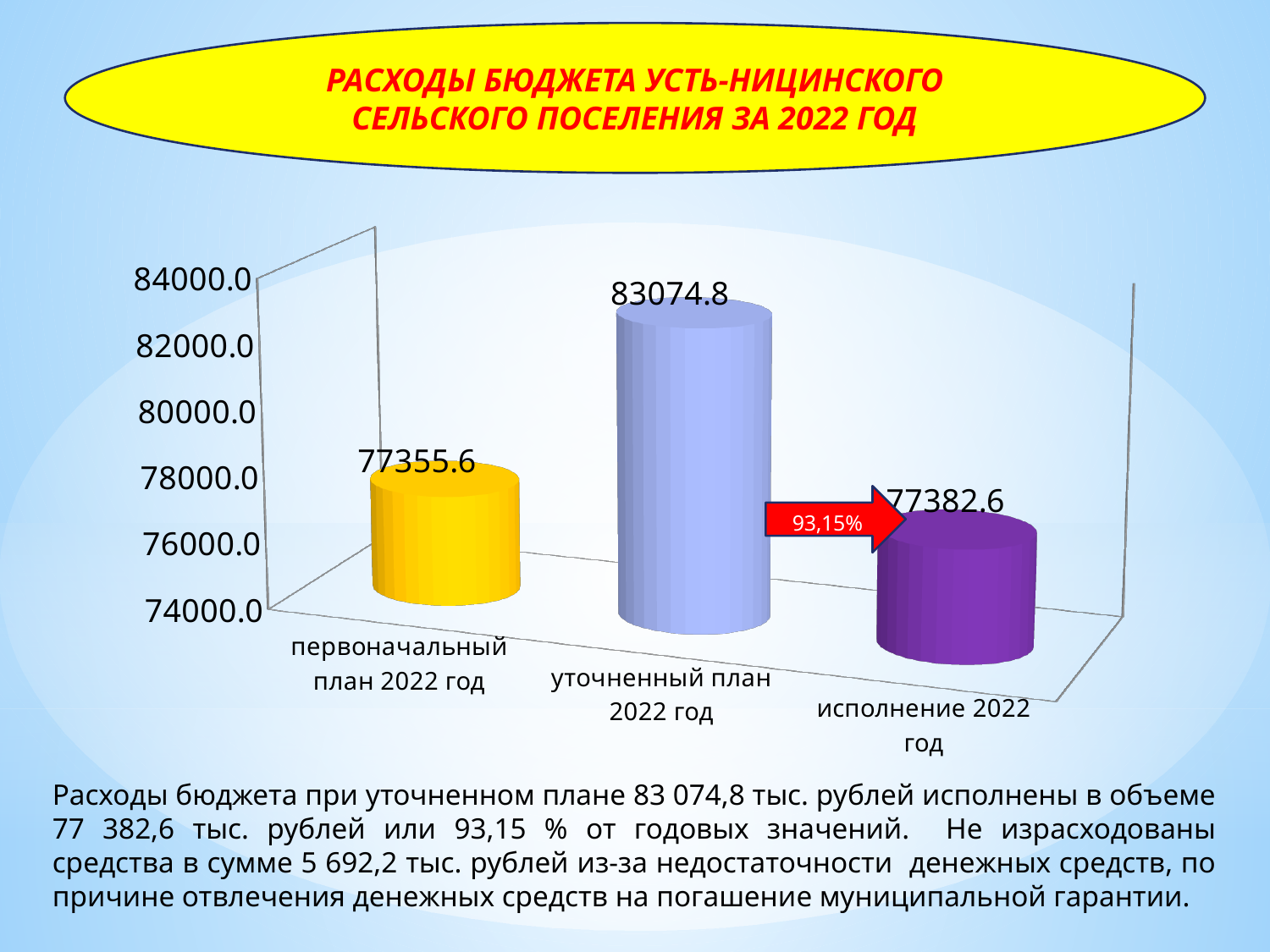
Is the value for исполнение 2022 год greater or less than 78000.0? less Is the value for уточненный план 2022 год greater or less than 82000.0? greater What is the value for исполнение 2022 год? 77382.6 Which category has the highest value? уточненный план 2022 год What is the value for уточненный план 2022 год? 83074.8 Which is larger, уточненный план 2022 год or исполнение 2022 год? уточненный план 2022 год What percentage is shown on the red arrow between the second and third bars? 93,15% How many categories are shown in the chart? 3 What kind of chart is shown on the slide? bar chart What is the value for первоначальный план 2022 год? 77355.6 What is the difference between уточненный план 2022 год and первоначальный план 2022 год? 5719.2 What is the difference between уточненный план 2022 год and исполнение 2022 год? 5692.2